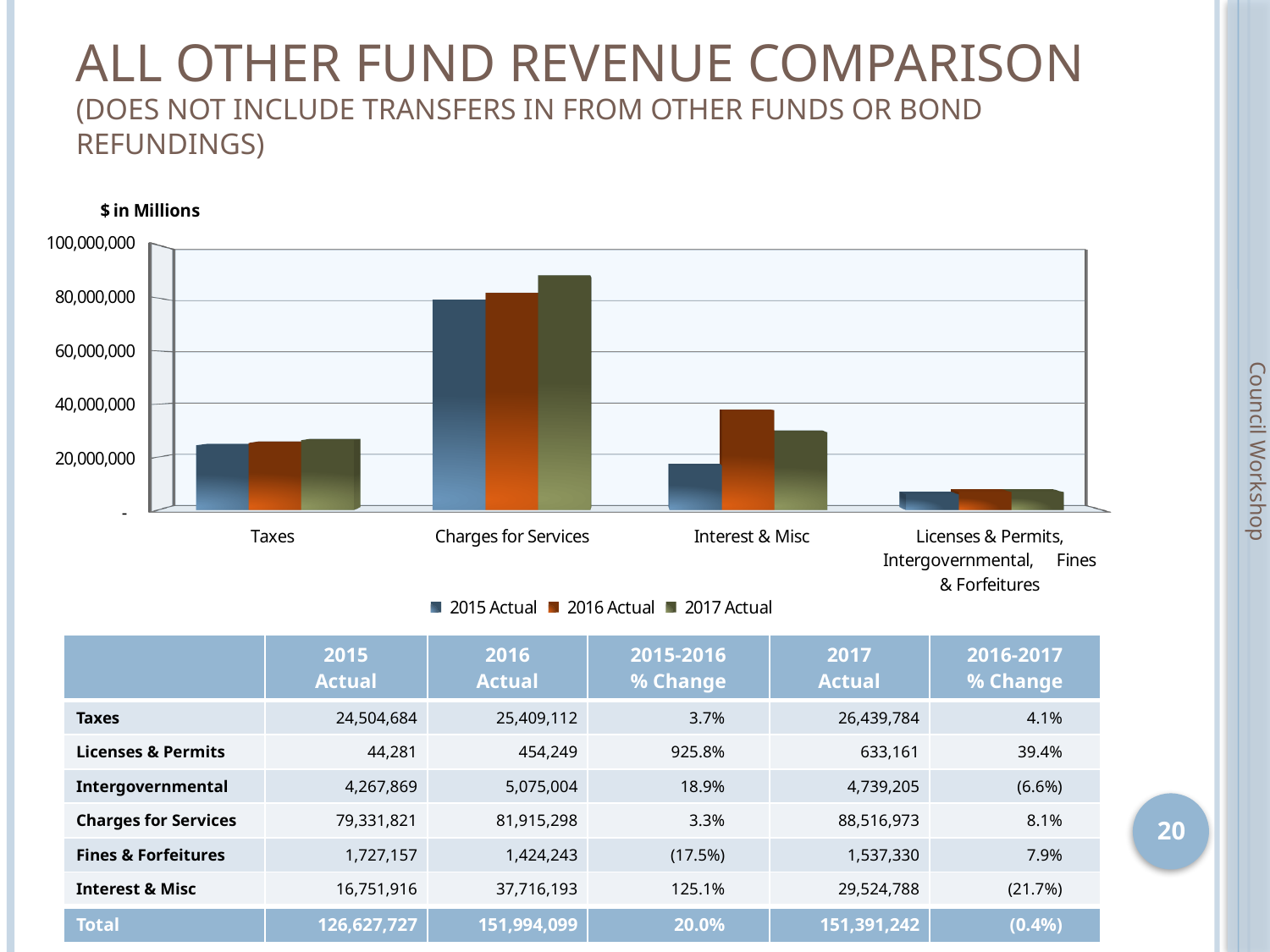
Is the 2015 Actual value for Taxes greater or less than 40,000,000? less Which category has the lowest bars in the chart? Licenses & Permits, Intergovernmental, Fines & Forfeitures Do the Charges for Services bars rise or fall from 2015 Actual to 2017 Actual? rise What are the three legend entries of the chart? 2015 Actual, 2016 Actual, 2017 Actual How many series does the chart legend list? 3 How many categories are shown along the x axis of the chart? 4 What is the 2017 Actual value for Charges for Services? 88,516,973 For Interest & Misc, which is larger: the 2016 Actual bar or the 2017 Actual bar? 2016 Actual What kind of chart is shown on the slide? bar chart Which category has the highest 2017 Actual bar in the chart? Charges for Services Is the 2016 Actual value for Interest & Misc greater or less than 20,000,000? greater What is the difference between the 2016 Actual and 2015 Actual values for Taxes? 904,428